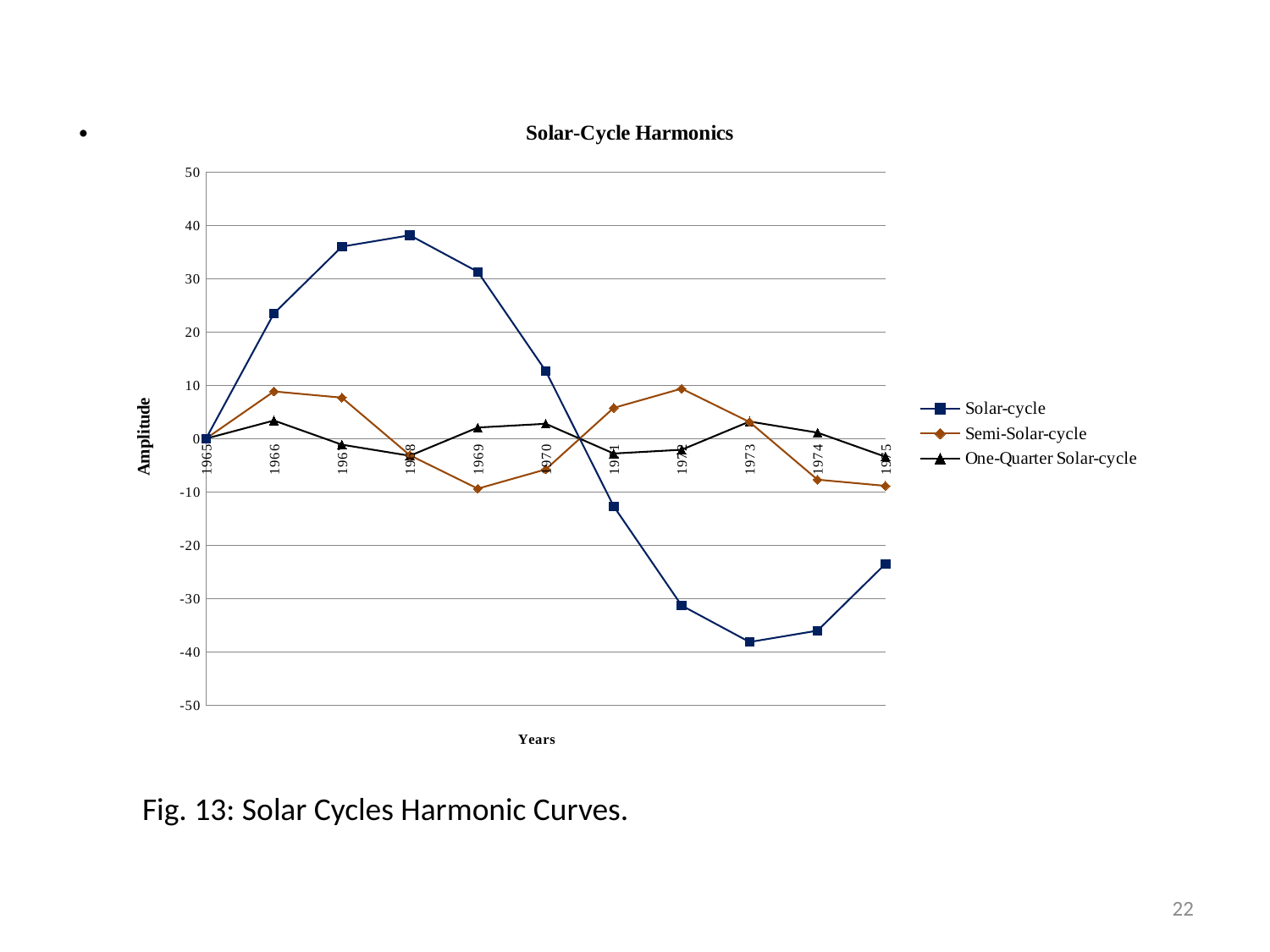
In which year does the Solar-cycle series reach its lowest value? 1973 How many years are plotted along the x axis? 11 In 1968, which series has the larger value, Solar-cycle or Semi-Solar-cycle? Solar-cycle Is the value for Solar-cycle in 1972 greater or less than -30? less Is the value for Solar-cycle in 1967 greater or less than 30? greater What is the label of the vertical axis? Amplitude How many series does the legend list? 3 In which year does the Solar-cycle series reach its highest value? 1968 What is the value of the Solar-cycle series in 1965? 0 Does the Solar-cycle series rise or fall between 1968 and 1973? fall What kind of chart is shown on the slide? line chart What is the title of the chart? Solar-Cycle Harmonics